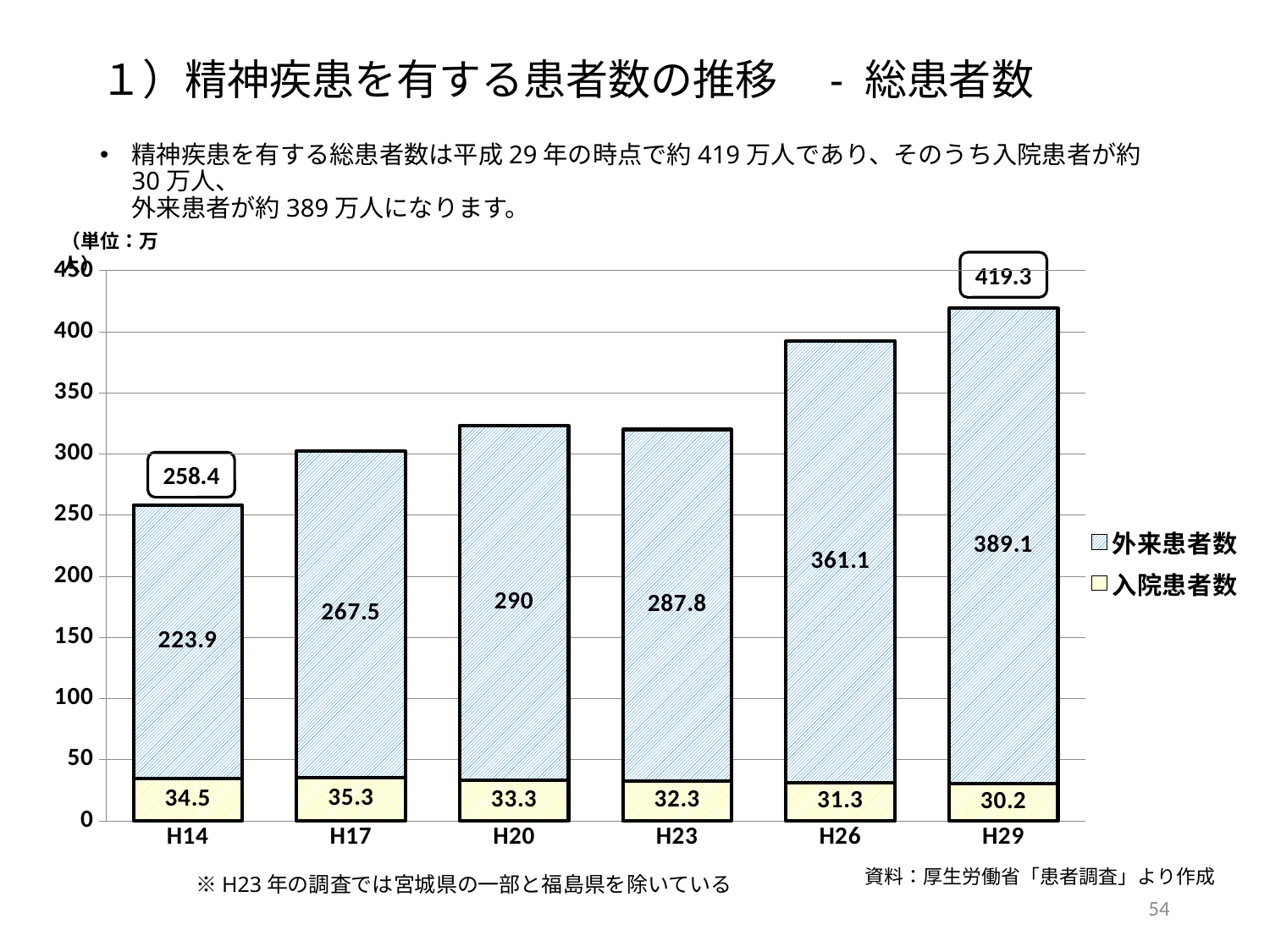
Which category has the highest value for 入院患者数? H17 Does the 入院患者数 series rise or fall from H17 to H29? fall What type of chart is shown on the slide? stacked bar chart What is the difference between the 外来患者数 values for H29 and H14? 165.2 What is the value of 外来患者数 for H26? 361.1 What is the total labelled above the H29 bar? 419.3 How many series does the legend list? 2 How many categories are shown on the x axis? 6 Which category has the lowest value for 外来患者数? H14 What is the value of 入院患者数 for H20? 33.3 Which is larger, the 入院患者数 value for H14 or for H29? H14 What is the total of the stacked bar for H23? 320.1